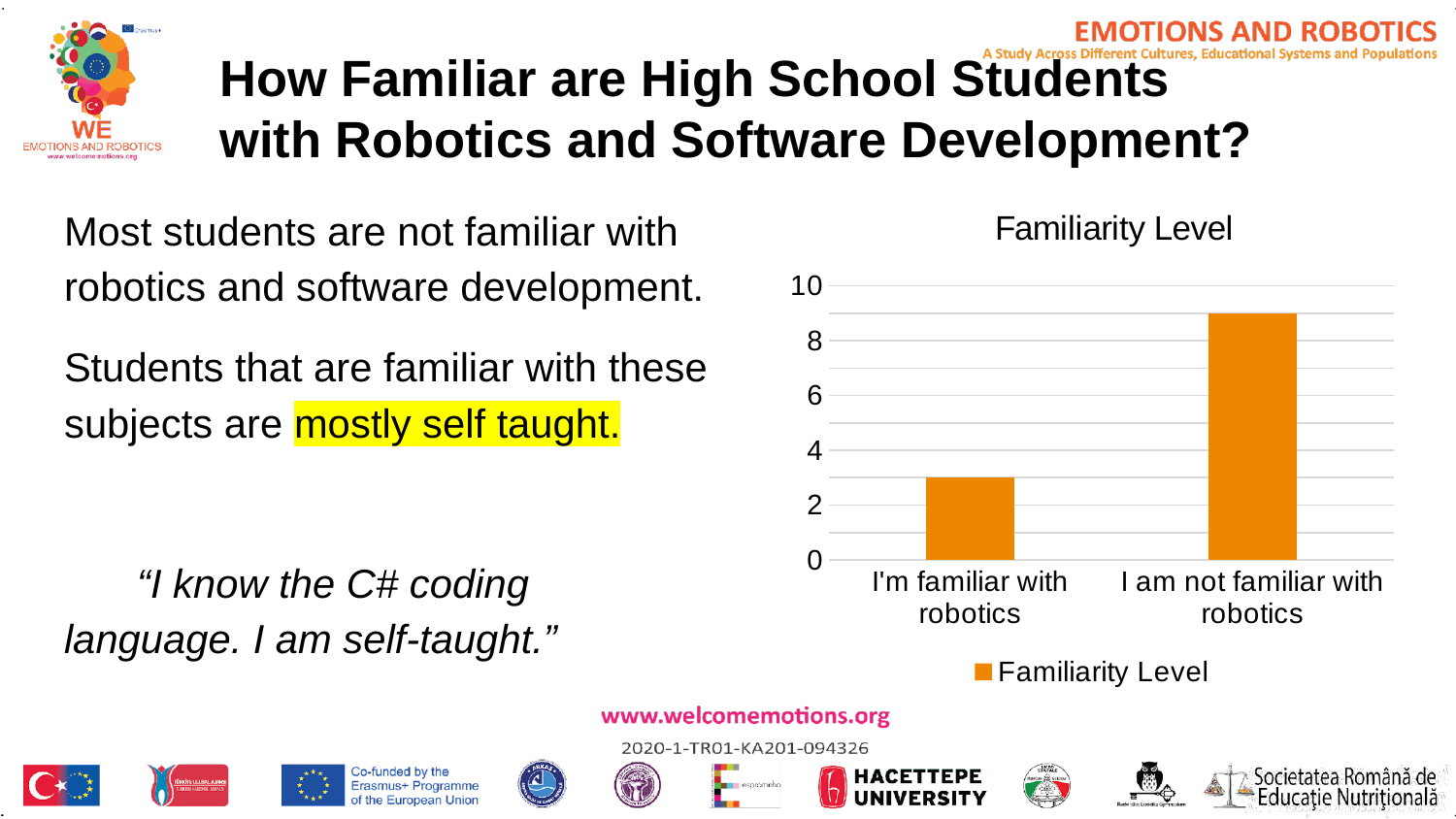
Is the value for "I am not familiar with robotics" greater or less than 8? greater Which is larger: the value for "I'm familiar with robotics" or the value for "I am not familiar with robotics"? I am not familiar with robotics Is the value for "I'm familiar with robotics" greater or less than 2? greater Which category has the lowest value in the Familiarity Level chart? I'm familiar with robotics What is the title of the chart on the slide? Familiarity Level How many categories are shown on the x axis of the Familiarity Level chart? 2 How many series does the legend of the chart list? 1 Which category has the highest value in the Familiarity Level chart? I am not familiar with robotics Is the value for "I am not familiar with robotics" greater or less than 10? less What kind of chart is shown on the slide? bar chart What is the highest value shown on the y axis of the chart? 10